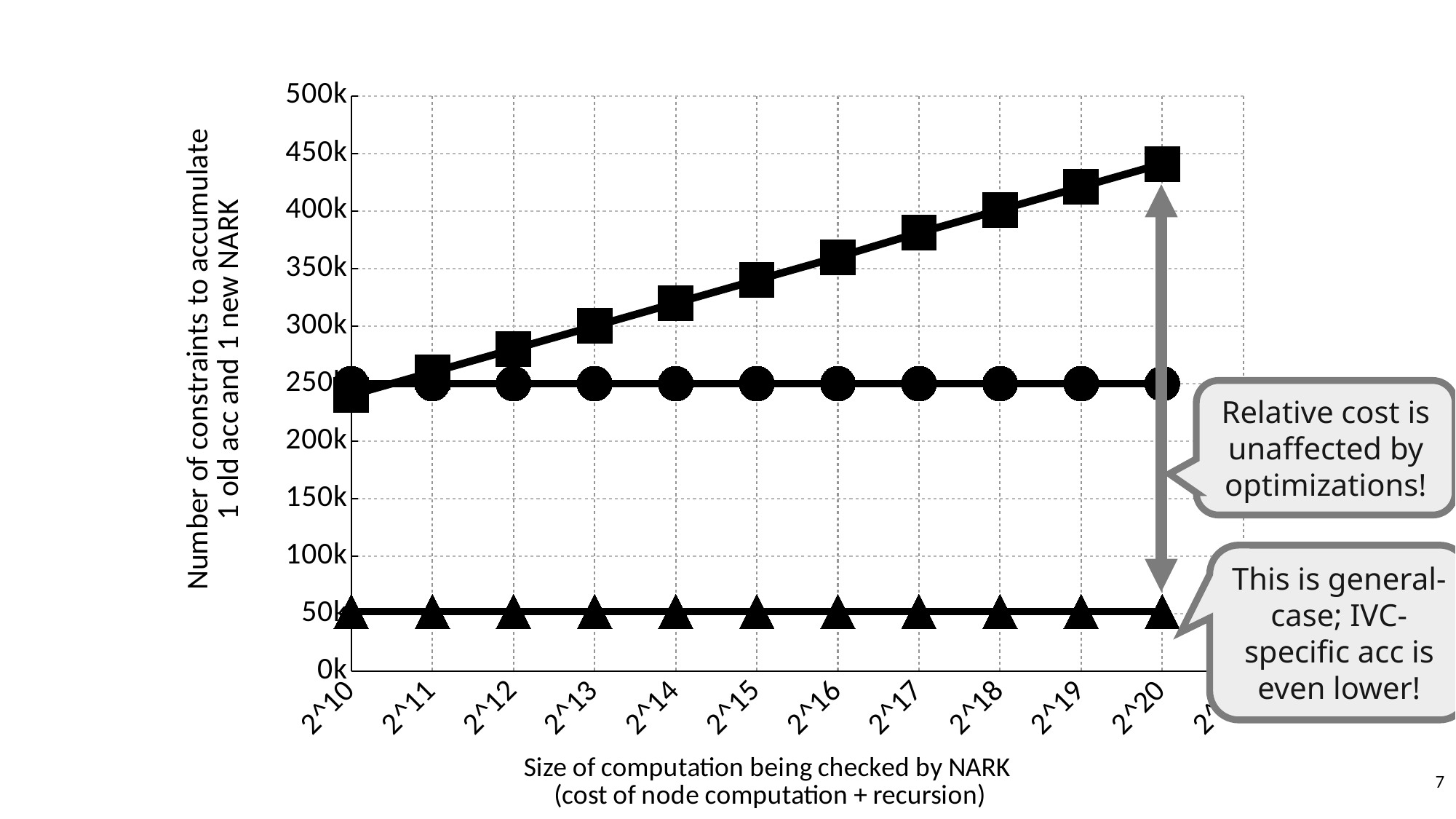
What kind of chart is shown on the slide? line chart Is the value of the square-marker series at 2^20 greater or less than 400k? greater How many x-axis categories from 2^10 to 2^20 are labeled on the chart? 11 Is the value of the circle-marker series at 2^15 greater or less than 200k? greater Is the value of the square-marker series at 2^10 greater or less than 250k? less At 2^20, which series has the highest value: square, circle, or triangle markers? square markers Does the series with square markers rise or fall as the computation size increases along the x axis? rise Does the series with circle markers rise, fall, or stay flat along the x axis? stay flat Which series has the lowest values across the chart? triangle markers How many lines (series) are plotted on the chart? 3 What is the x-axis title of the chart? Size of computation being checked by NARK (cost of node computation + recursion)